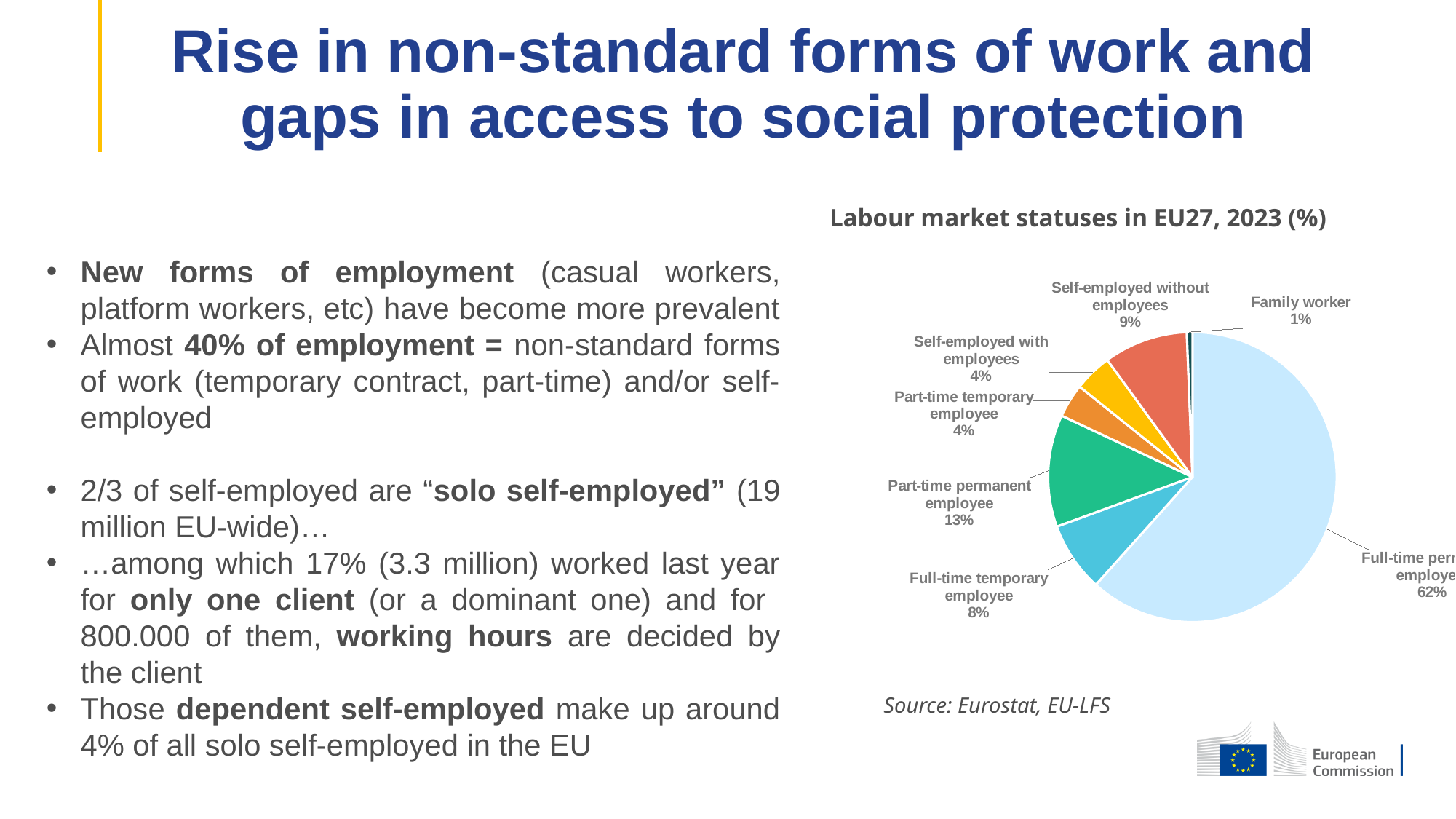
What share of the pie is Family worker? 1% What is the share of the largest slice in the pie chart? 62% Which labour market status has the smallest share in the pie chart? Family worker What share of the pie is Full-time temporary employee? 8% What share of the pie is Part-time permanent employee? 13% How many slices does the pie chart have? 7 Which has the larger share, Self-employed without employees or Full-time temporary employee? Self-employed without employees What is the difference in share between Part-time permanent employee and Full-time temporary employee? 5% What kind of chart is shown on the slide? Pie chart What is the title of the chart? Labour market statuses in EU27, 2023 (%)